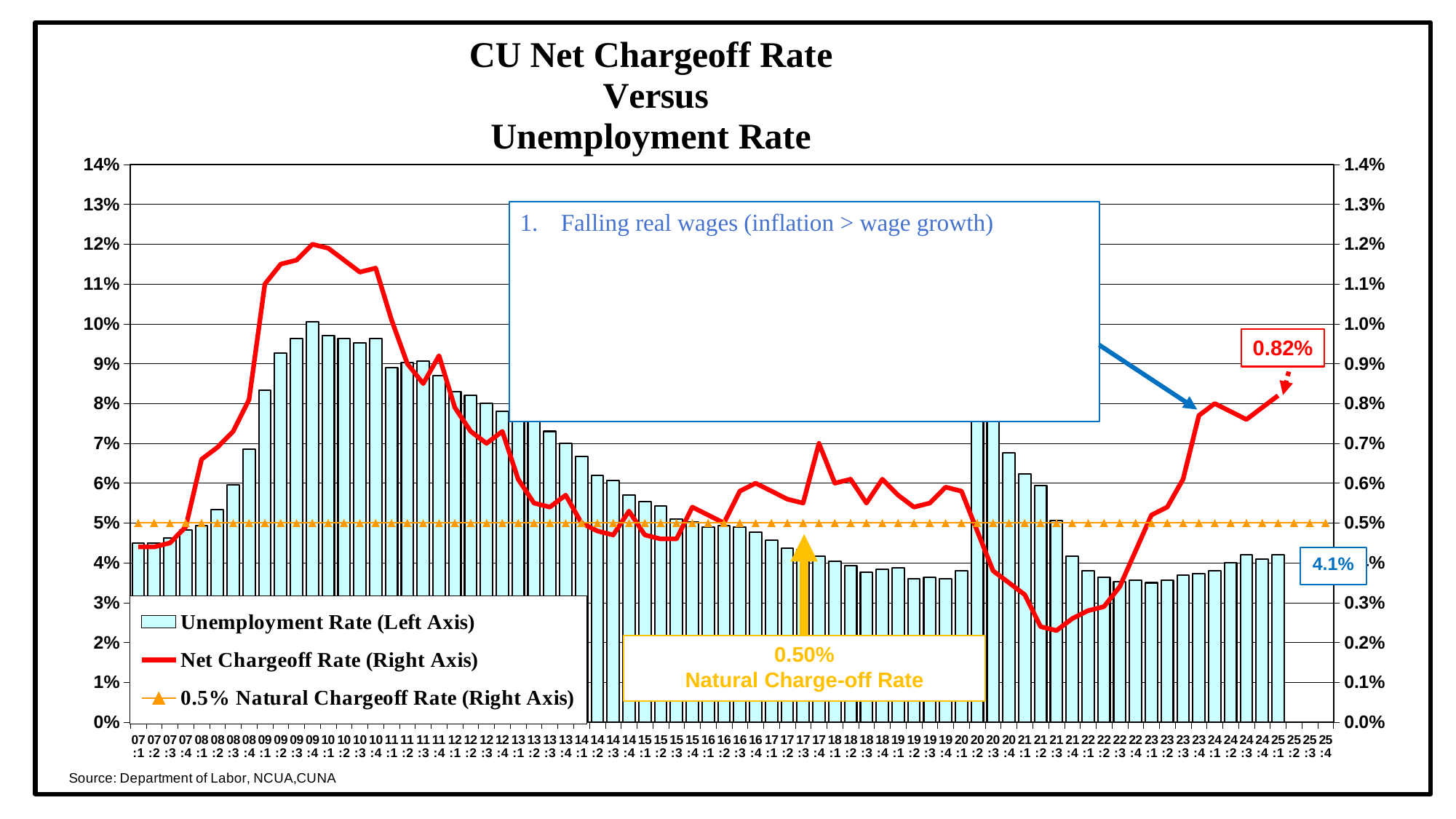
Does the Net Chargeoff Rate rise or fall from 21:3 to 25:1? rise What value is given for the Natural Charge-off Rate? 0.50% Is the Net Chargeoff Rate in 21:3 greater or less than 0.3%? less What is the labelled Unemployment Rate at the end of the series (25:1)? 4.1% What is the difference between the latest Net Chargeoff Rate (0.82%) and the 0.50% Natural Charge-off Rate? 0.32% What kind of chart is shown on the slide? Combined bar and line chart What is the labelled Net Chargeoff Rate at the end of the series (25:1)? 0.82% Is the Net Chargeoff Rate in 09:4 greater or less than 1.1%? greater Does the Unemployment Rate rise or fall from 09:4 to 19:4? fall How many series does the legend list? 3 Which quarter has the highest Unemployment Rate bar? 20:2 What source is cited for the chart data? Department of Labor, NCUA, CUNA